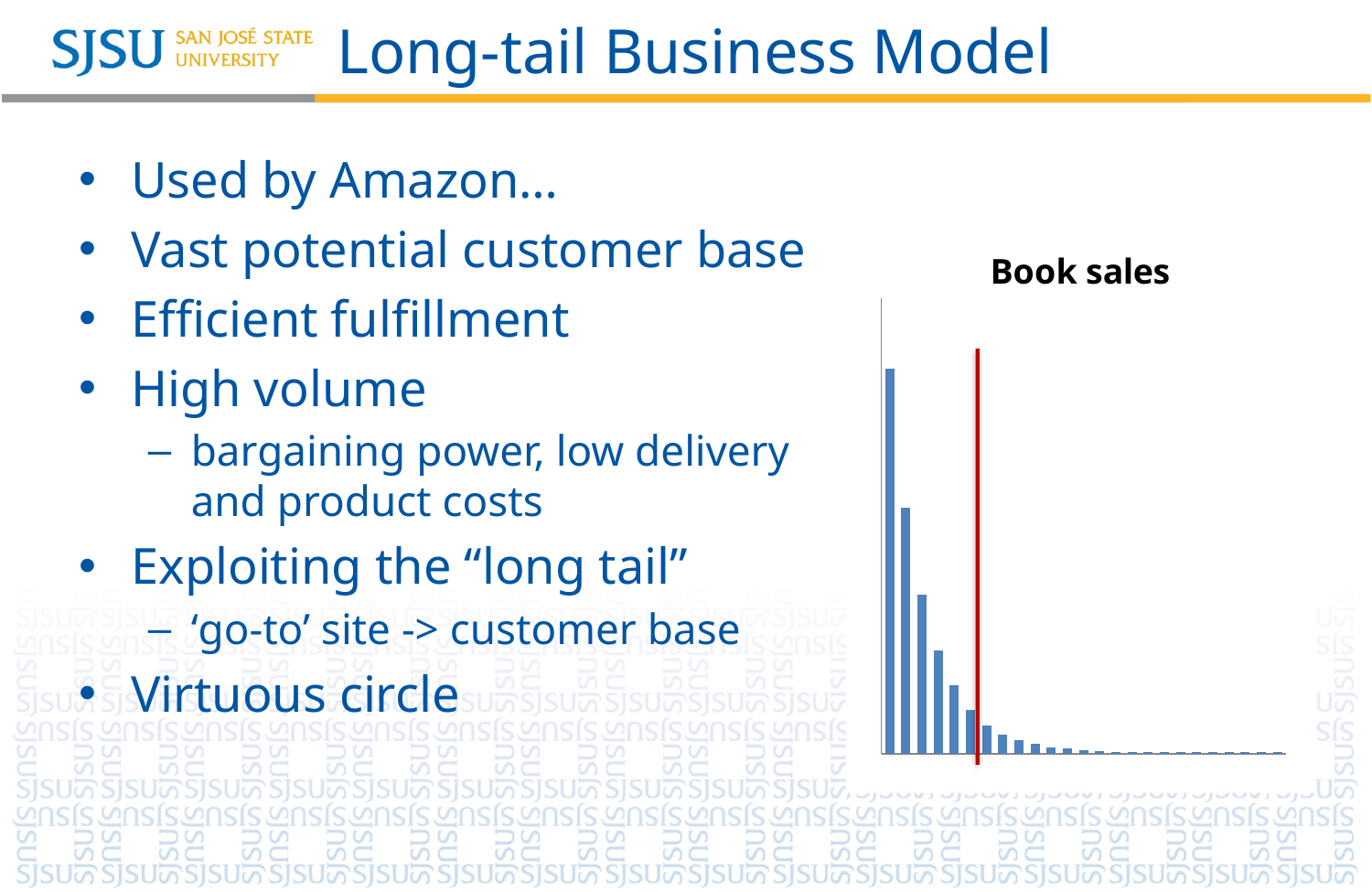
What is the title of the chart on the slide? Book sales Which bar in the Book sales chart is the tallest? the leftmost bar What kind of chart is shown on the slide? bar chart In the Book sales chart, is the second bar taller or shorter than the third bar? taller Do the bar heights in the Book sales chart rise or fall from left to right? fall What colour are the bars in the Book sales chart? blue In the Book sales chart, is the leftmost bar taller or shorter than the second bar? taller Are the bars in the Book sales chart vertical or horizontal? vertical Where are the shortest bars located in the Book sales chart? on the right side